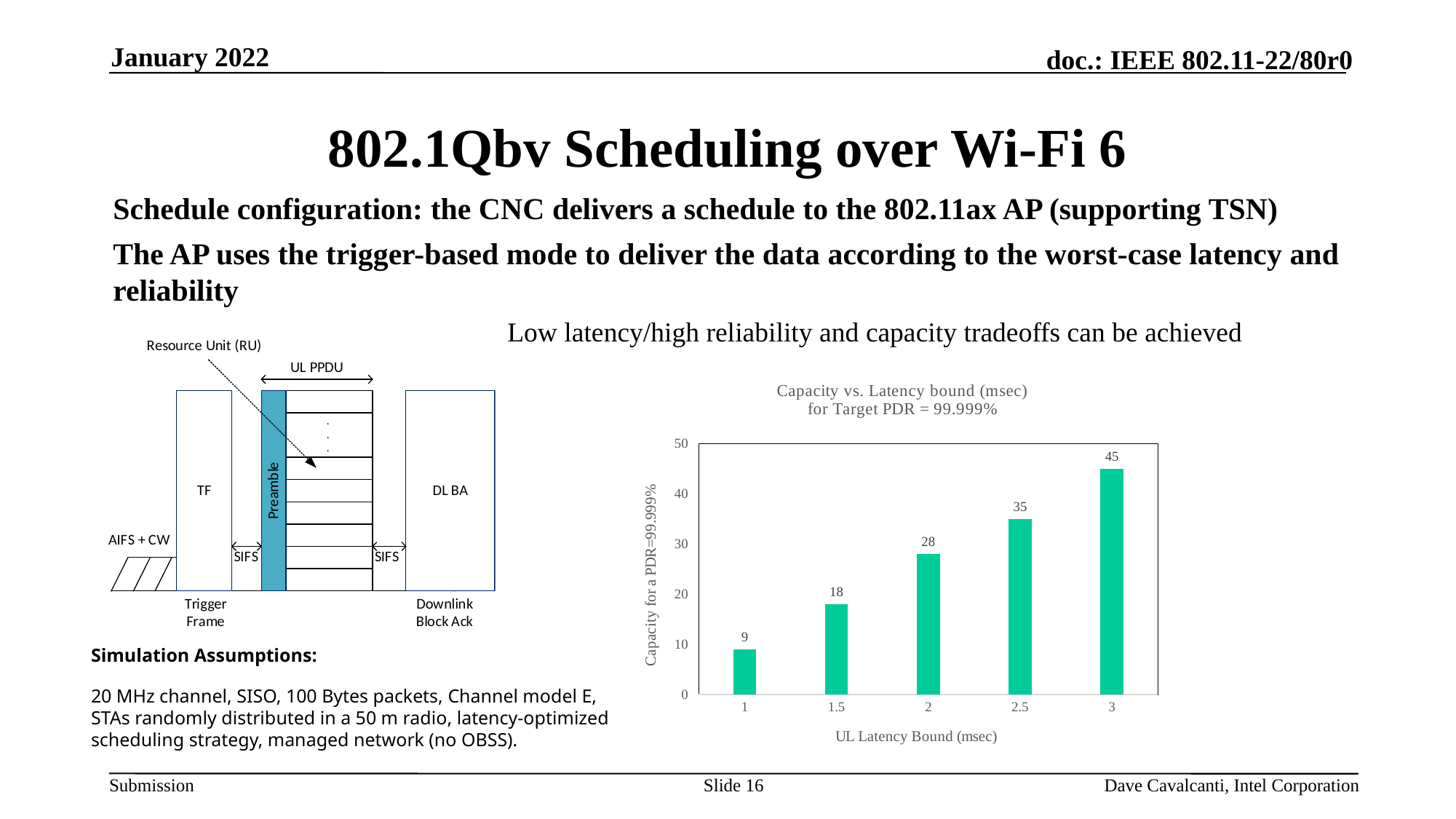
What is the capacity value for a UL latency bound of 2 msec? 28 What is the title of the chart? Capacity vs. Latency bound (msec) for Target PDR = 99.999% What is the difference in capacity between a latency bound of 2 msec and 1.5 msec? 10 How many latency bound categories are plotted in the chart? 5 What is the capacity value for a UL latency bound of 2.5 msec? 35 Which UL latency bound has the lowest capacity? 1 Do the capacity values rise or fall as the UL latency bound increases? rise Which UL latency bound has the highest capacity? 3 What is the capacity value for a UL latency bound of 1 msec? 9 What is the difference in capacity between a latency bound of 3 msec and 1 msec? 36 What kind of chart is shown on the slide? bar chart Which has a larger capacity: a latency bound of 1.5 msec or 2.5 msec? 2.5